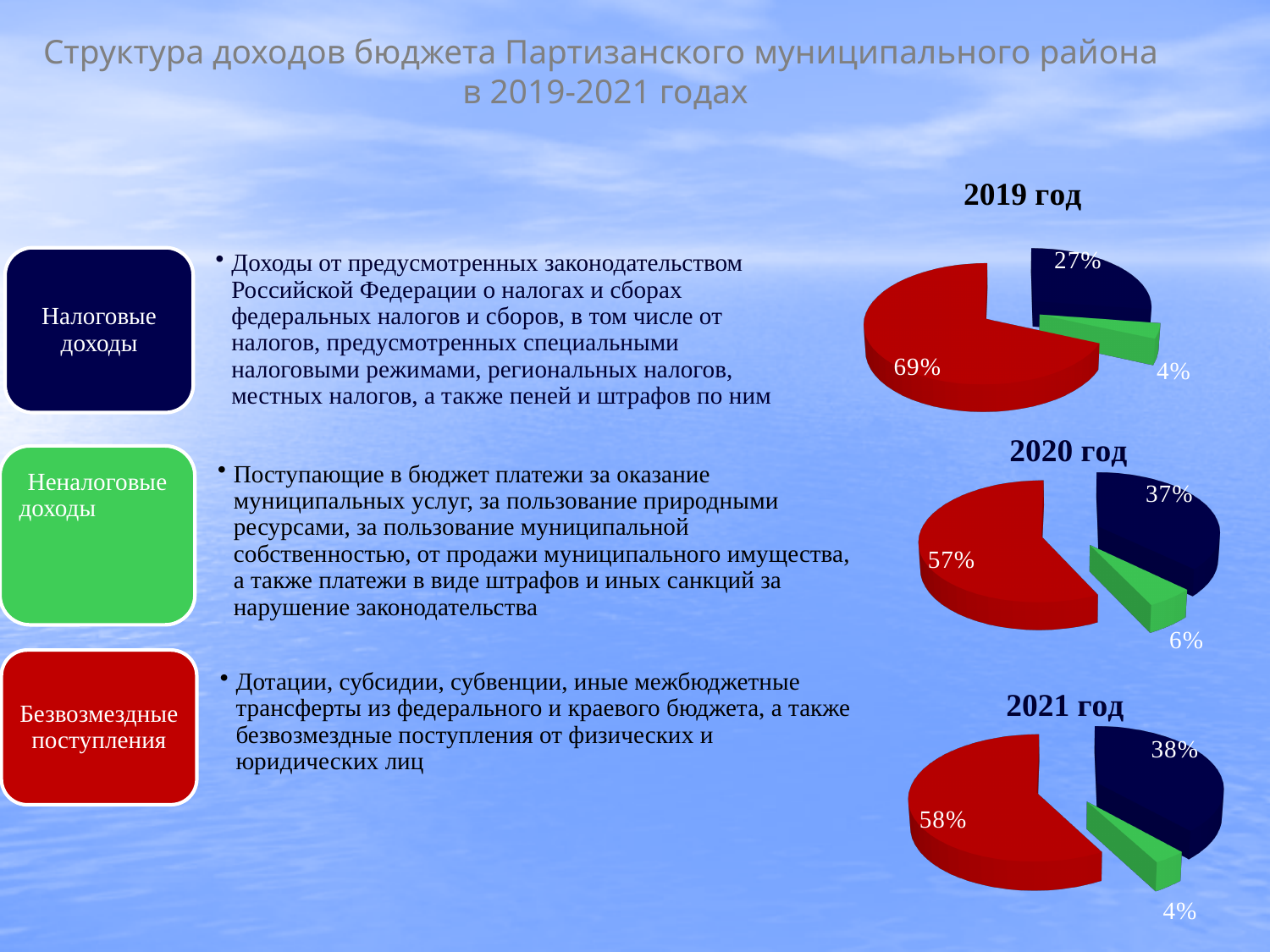
In the 2019 год chart, what share does the dark blue slice (Налоговые доходы) have? 27% In the 2021 год chart, which slice is the largest? The red slice (Безвозмездные поступления), 58% In the 2020 год chart, which slice is the smallest? The green slice (Неналоговые доходы), 6% In the 2020 год chart, what share does the dark blue slice (Налоговые доходы) have? 37% In the 2019 год chart, what is the difference between the red slice (69%) and the dark blue slice (27%)? 42 percentage points What type of chart is used for each year on the slide? Pie chart Which is larger: the dark blue slice in the 2020 год chart or the dark blue slice in the 2021 год chart? The 2021 год chart (38% vs 37%) In the 2019 год chart, what share does the green slice (Неналоговые доходы) have? 4% How many pie charts are shown on the slide? 3 In the 2019 год chart, what share does the red slice (Безвозмездные поступления) have? 69% In the 2020 год chart, what share does the green slice (Неналоговые доходы) have? 6% In the 2021 год chart, what share does the red slice (Безвозмездные поступления) have? 58%